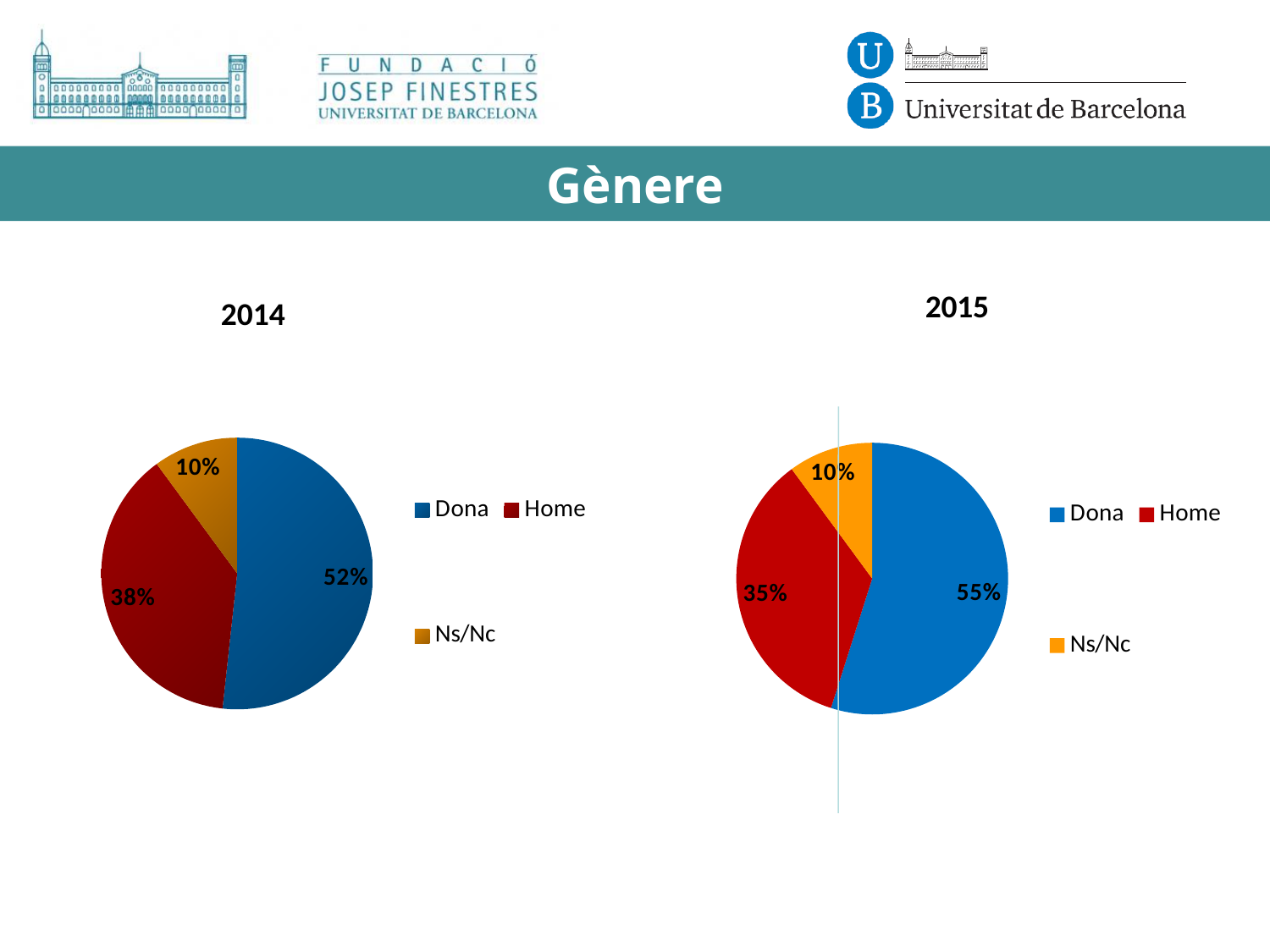
In the 2015 chart, what share does Ns/Nc have? 10% In the 2014 chart, what is the difference between the Dona and Home shares? 14% In the 2015 chart, which category has the smallest slice? Ns/Nc What kind of chart is the 2014 chart? Pie chart In the 2015 chart, which is larger, Dona or Home? Dona In the 2015 chart, what share does Dona have? 55% In the 2014 chart, what share does Home have? 38% In the 2014 chart, which category has the largest slice? Dona In the 2015 chart, what share does Home have? 35% What is the title of the 2015 chart? 2015 In the 2014 chart, what share does Dona have? 52% How many categories does the 2015 chart show? 3